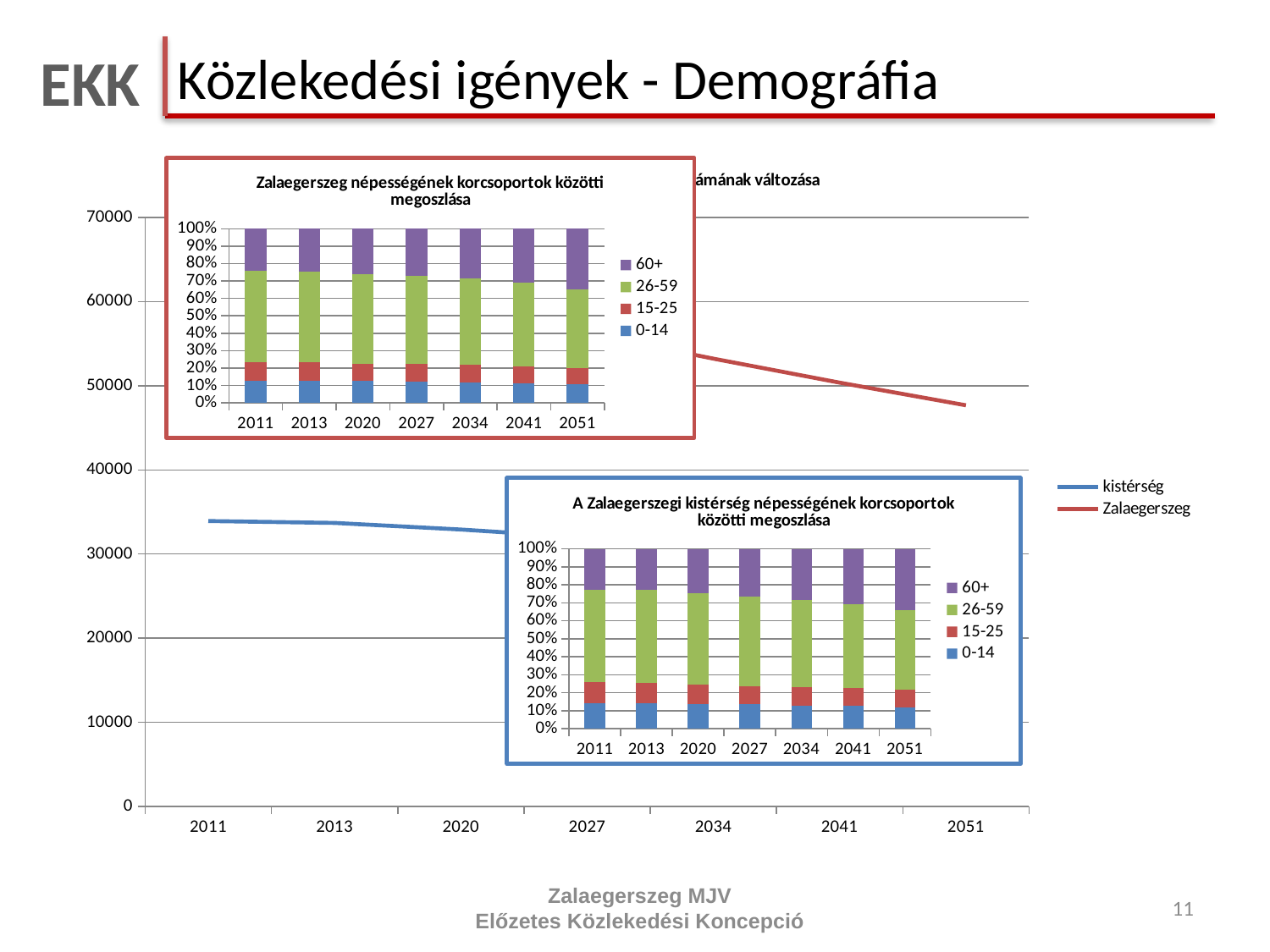
In the large background line chart, is the value for Zalaegerszeg in 2051 greater or less than 50000? less In the chart titled 'Zalaegerszeg népességének korcsoportok közötti megoszlása', does the share of the 26-59 group rise or fall from 2011 to 2051? fall In the large background line chart, does the kistérség line rise or fall from 2011 onward? fall How many series does the legend of the chart titled 'A Zalaegerszegi kistérség népességének korcsoportok közötti megoszlása' list? 4 In the large background line chart, is the value for kistérség in 2011 greater or less than 30000? greater In the chart titled 'A Zalaegerszegi kistérség népességének korcsoportok közötti megoszlása', does the share of the 60+ group rise or fall from 2011 to 2051? rise How many years are shown on the x axis of the chart titled 'Zalaegerszeg népességének korcsoportok közötti megoszlása'? 7 In the chart titled 'A Zalaegerszegi kistérség népességének korcsoportok közötti megoszlása', which colour represents the 0-14 age group? blue How many series does the legend of the large background line chart list? 2 What kind of chart is the large chart in the background with the kistérség and Zalaegerszeg series? line chart What kind of chart is the chart titled 'Zalaegerszeg népességének korcsoportok közötti megoszlása'? stacked bar chart